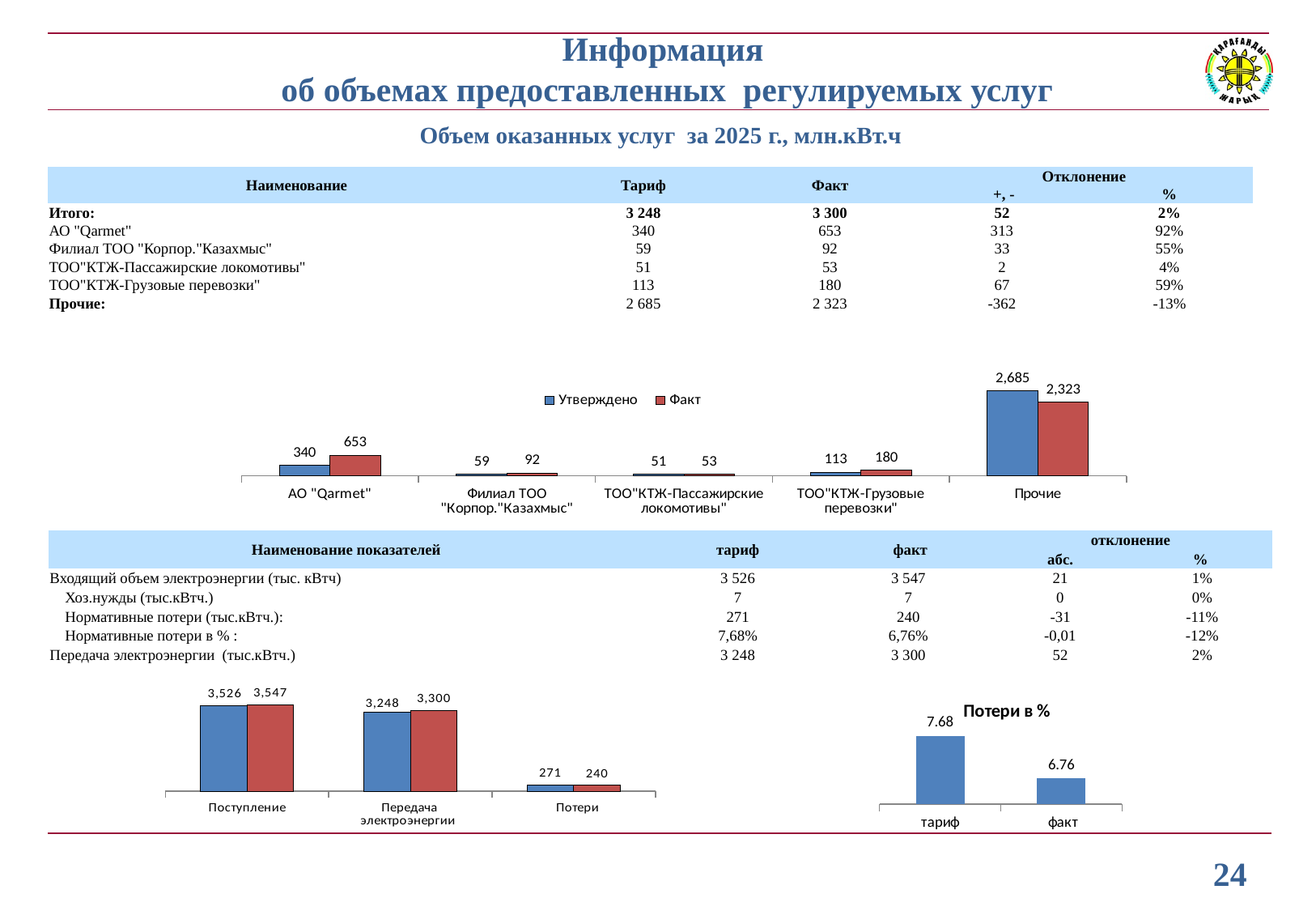
In the bottom-left chart, what is the difference between the two bars for Передача электроэнергии? 52 In the top chart with the legend Утверждено and Факт, which category has the lowest Утверждено value? ТОО"КТЖ-Пассажирские локомотивы" In the top chart with the legend Утверждено and Факт, how many series does the legend list? 2 In the top chart with the legend Утверждено and Факт, which category has the highest Факт value? Прочие In the bottom-left chart, which is larger for Поступление: the blue bar or the red bar? the red bar (3,547) In the top chart with the legend Утверждено and Факт, what is the Утверждено value for Прочие? 2,685 What type of chart is the chart titled Потери в %? bar chart In the top chart with the legend Утверждено and Факт, what is the Факт value for АО "Qarmet"? 653 In the chart titled Потери в %, what is the value for факт? 6.76 In the top chart with the legend Утверждено and Факт, how many categories are shown on the x axis? 5 In the bottom-left chart, what is the red (second) bar value for Потери? 240 In the top chart with the legend Утверждено and Факт, what is the difference between the Факт and Утверждено values for ТОО"КТЖ-Грузовые перевозки"? 67